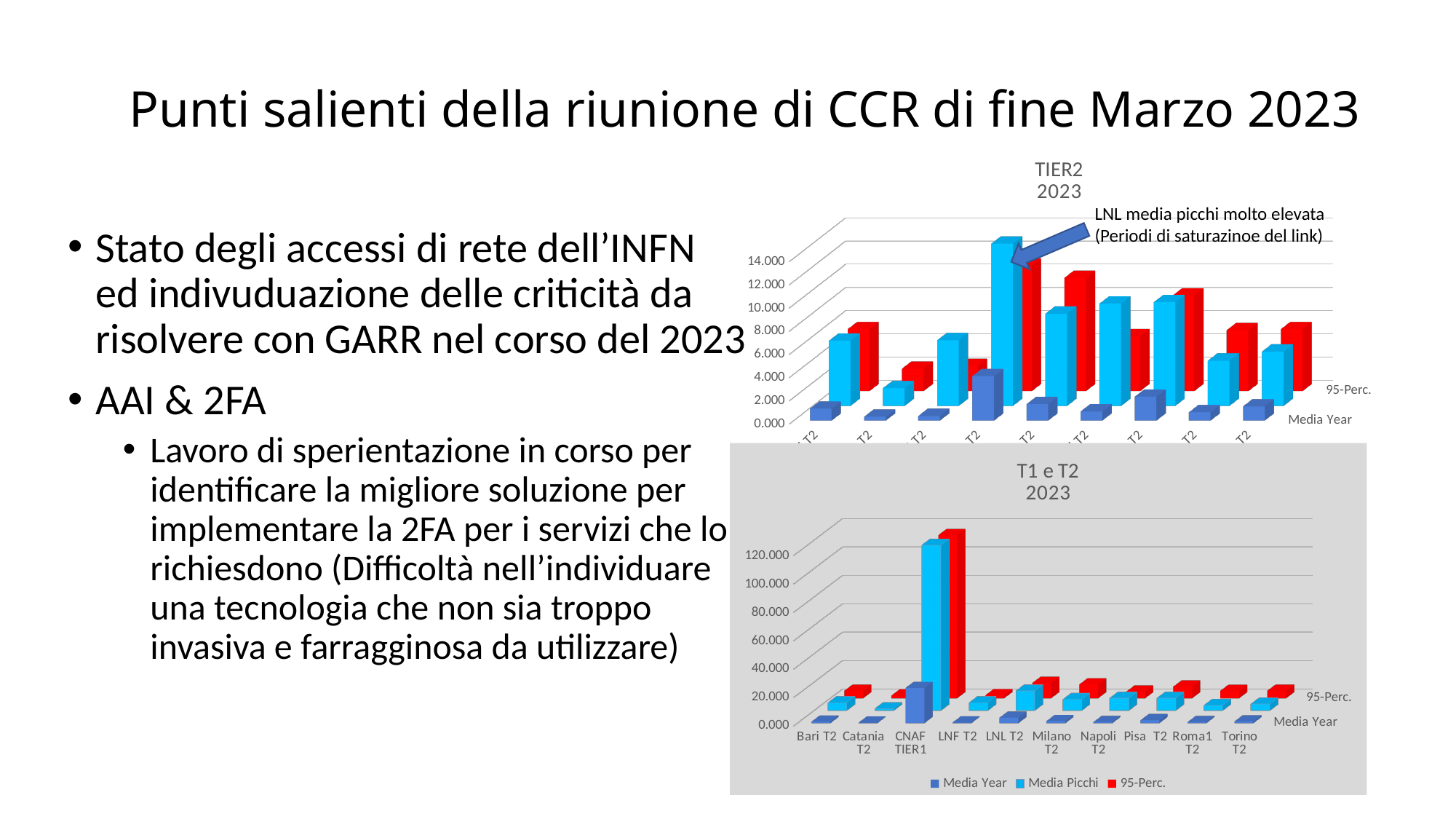
In the 'T1 e T2 2023' chart, which category has the highest 95-Perc. value? CNAF TIER1 In the 'T1 e T2 2023' chart, how many series does the legend list? 3 What is the title of the chart at the top right of the slide? TIER2 2023 In the 'T1 e T2 2023' chart, which category has the highest Media Picchi value? CNAF TIER1 What kind of chart is the 'TIER2 2023' chart at the top right of the slide? bar chart In the 'T1 e T2 2023' chart, is the Media Picchi value for Bari T2 greater or less than 20.000? less In the 'T1 e T2 2023' chart, which series is drawn in red according to the legend? 95-Perc. In the 'T1 e T2 2023' chart, is the Media Picchi value for CNAF TIER1 greater or less than 100.000? greater In the 'TIER2 2023' chart, is the tallest light-blue bar greater or less than 12.000? greater In the 'T1 e T2 2023' chart, how many categories are shown on the x axis? 10 In the 'T1 e T2 2023' chart, which is larger: the Media Picchi value for CNAF TIER1 or for LNF T2? CNAF TIER1 What kind of chart is the 'T1 e T2 2023' chart at the bottom right of the slide? bar chart